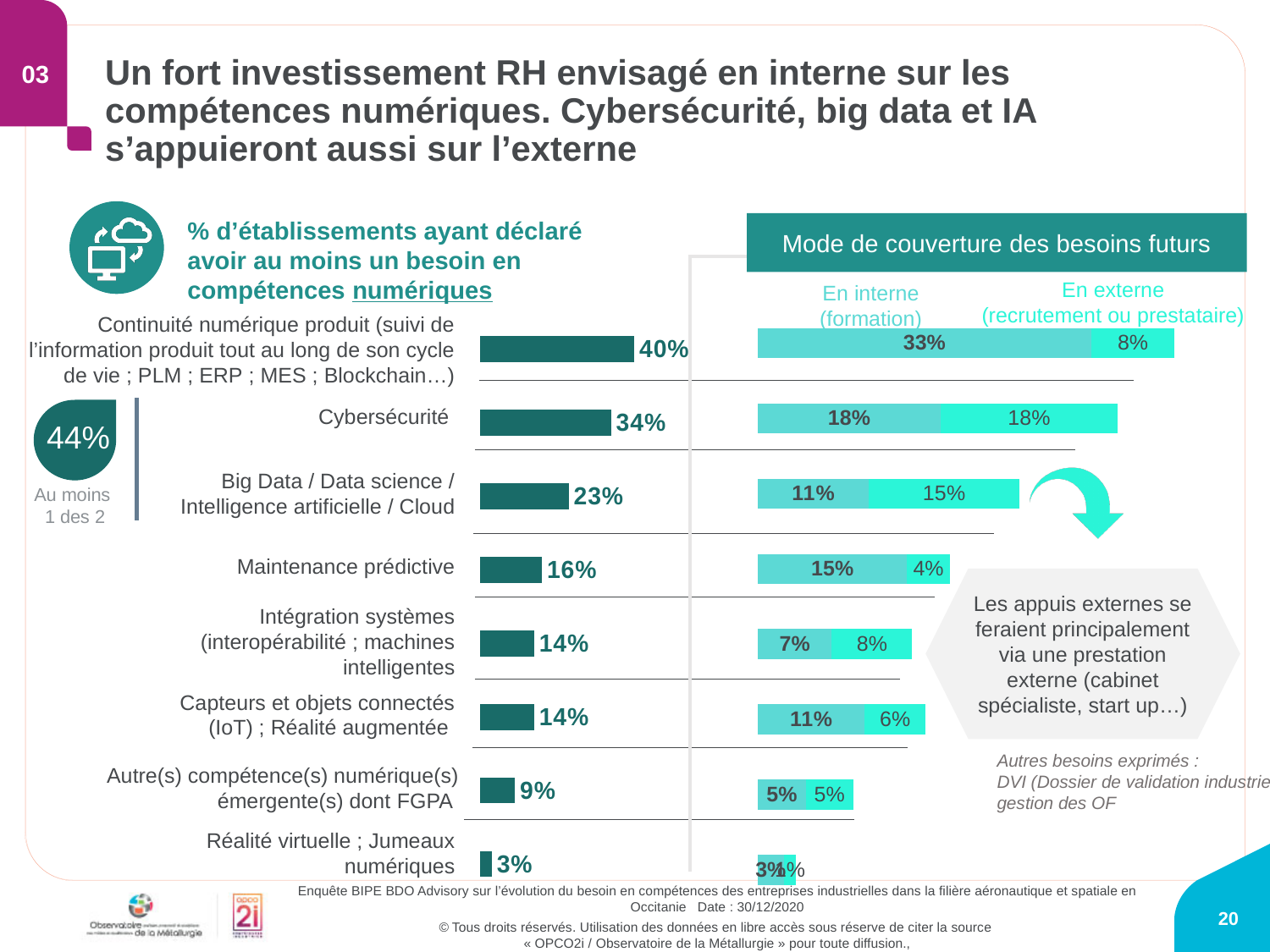
What type of chart is the left chart (% d'établissements ayant déclaré avoir au moins un besoin en compétences numériques)? Bar chart In the left chart (% d'établissements ayant déclaré avoir au moins un besoin en compétences numériques), what is the difference between Continuité numérique produit and Big Data / Data science / Intelligence artificielle / Cloud? 17% In the left chart (% d'établissements ayant déclaré avoir au moins un besoin en compétences numériques), which category has the lowest value? Réalité virtuelle ; Jumeaux numériques In the chart 'Mode de couverture des besoins futurs', what is the total of the stacked bar for Cybersécurité? 36% In the left chart (% d'établissements ayant déclaré avoir au moins un besoin en compétences numériques), which category has the highest value? Continuité numérique produit (suivi de l'information produit tout au long de son cycle de vie ; PLM ; ERP ; MES ; Blockchain…) In the chart 'Mode de couverture des besoins futurs', which is larger for Continuité numérique produit: 'En interne (formation)' or 'En externe (recrutement ou prestataire)'? En interne (formation) In the chart 'Mode de couverture des besoins futurs', what is the difference between the 'En interne (formation)' and 'En externe (recrutement ou prestataire)' values for Capteurs et objets connectés (IoT) ; Réalité augmentée? 5% In the left chart (% d'établissements ayant déclaré avoir au moins un besoin en compétences numériques), what is the value for Cybersécurité? 34% In the left chart (% d'établissements ayant déclaré avoir au moins un besoin en compétences numériques), how many categories are shown? 8 In the chart 'Mode de couverture des besoins futurs', what is the 'En externe (recrutement ou prestataire)' value for Big Data / Data science / Intelligence artificielle / Cloud? 15% In the chart 'Mode de couverture des besoins futurs', what is the 'En interne (formation)' value for Maintenance prédictive? 15% In the chart 'Mode de couverture des besoins futurs', how many series does the legend list? 2